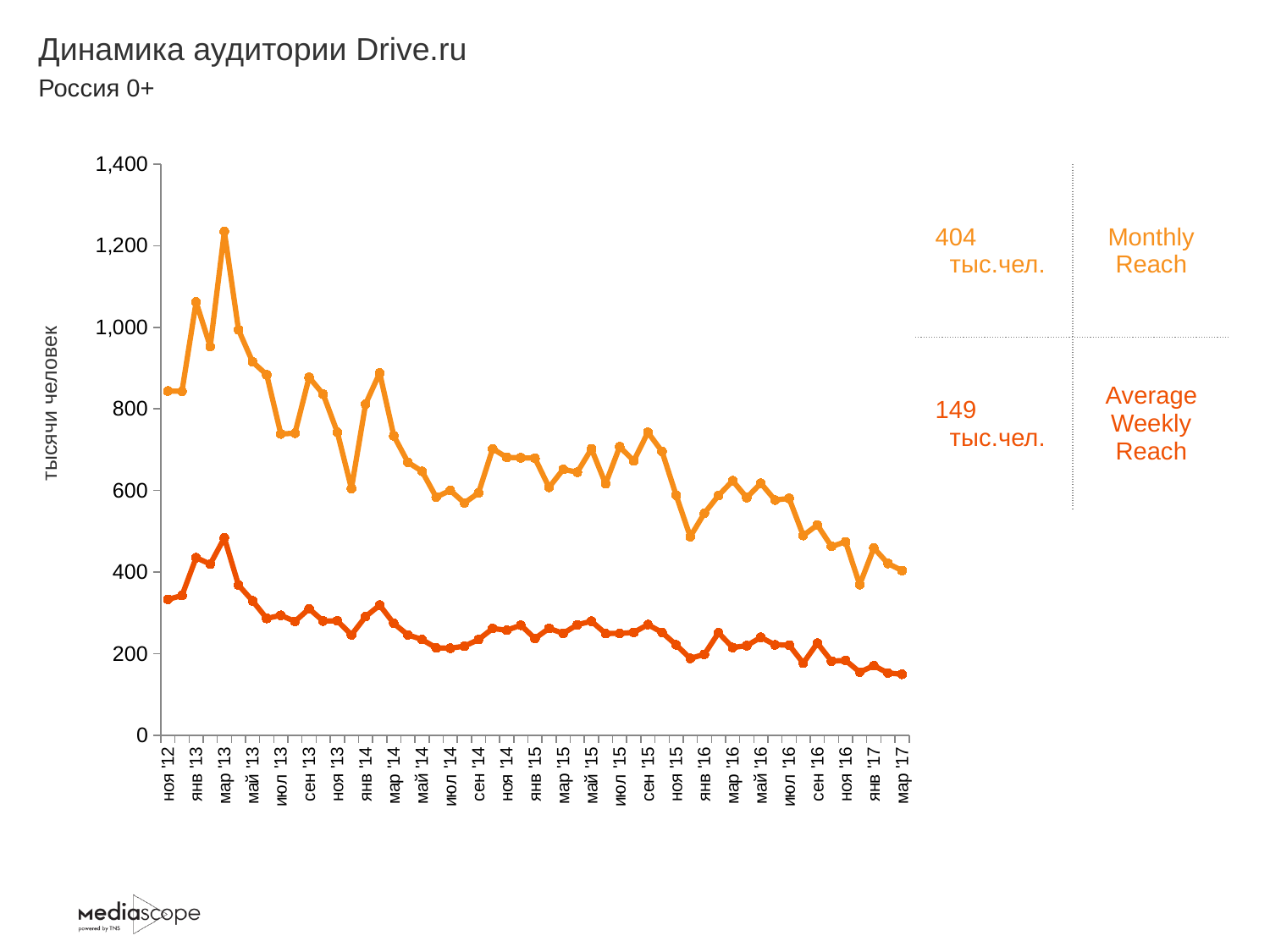
What is the Average Weekly Reach value for мар '17? 149 тыс.чел. Does Monthly Reach rise or fall overall from ноя '12 to мар '17? fall What is the title of the vertical axis? тысячи человек How many series are plotted on the chart? 2 What kind of chart is shown on the slide? line chart Which is larger in мар '17: Monthly Reach or Average Weekly Reach? Monthly Reach Is the Monthly Reach value for ноя '12 greater or less than 800? greater What is the Monthly Reach value for мар '17? 404 тыс.чел. What is the difference between Monthly Reach and Average Weekly Reach in мар '17? 255 тыс.чел. Is the Monthly Reach value for мар '13 greater or less than 1,000? greater Is the Average Weekly Reach value for мар '13 greater or less than 400? greater In which month does Monthly Reach reach its highest value? мар '13